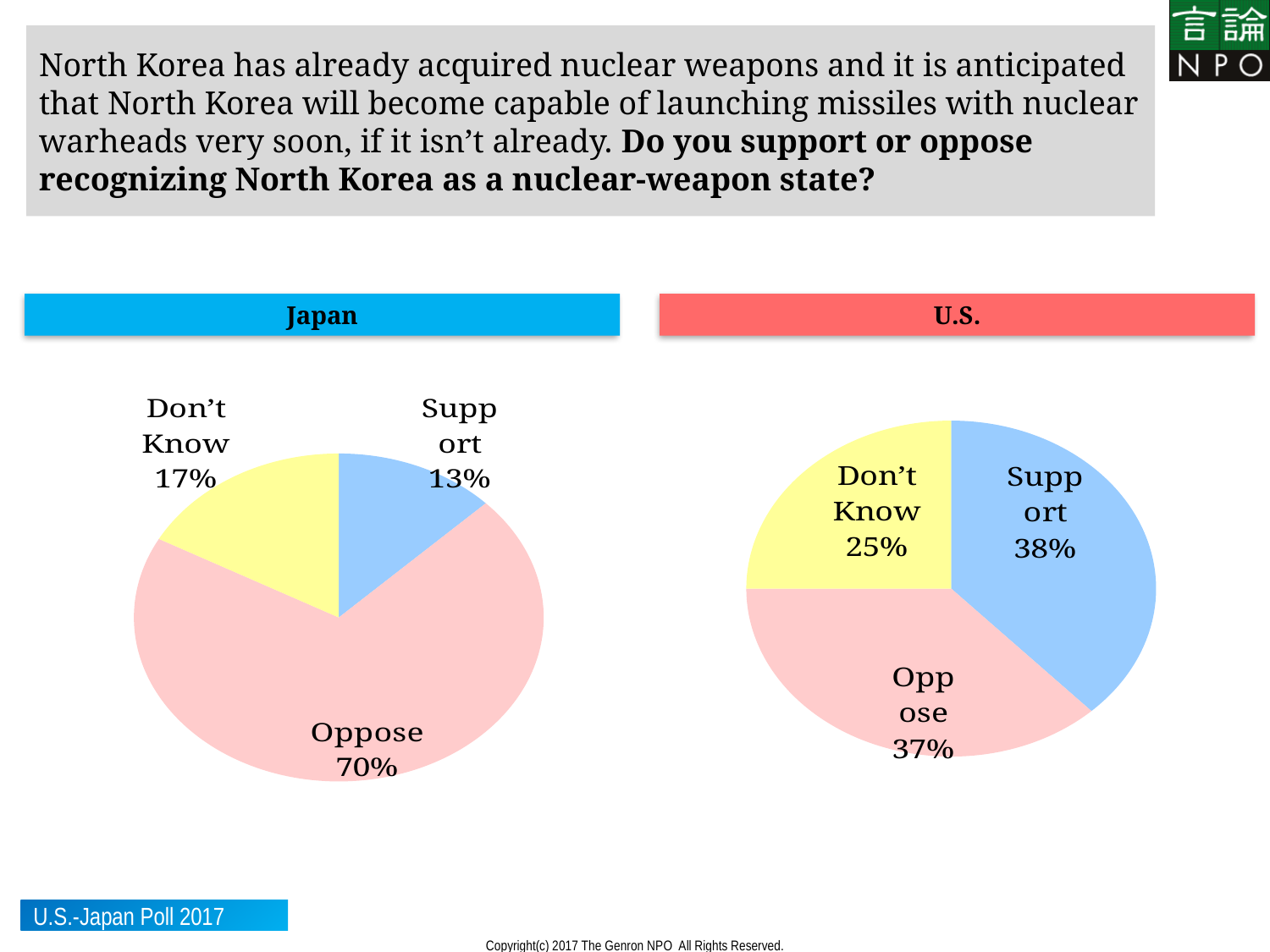
Which is larger: the Support share in the U.S. chart or the Support share in the Japan chart? U.S. What is the difference between the Oppose share in the Japan chart and the Oppose share in the U.S. chart? 33 percentage points In the Japan pie chart, which response has the largest share? Oppose In the Japan pie chart, which response has the smallest share? Support In the Japan pie chart, what share of respondents answered Support? 13% What type of chart is used to show the Japan results? Pie chart In the Japan pie chart, what percentage of respondents oppose recognizing North Korea as a nuclear-weapon state? 70% In the U.S. pie chart, what percentage of respondents answered Don't Know? 25% In the Japan pie chart, what is the difference between the Don't Know share and the Support share? 4 percentage points How many slices does the U.S. pie chart have? 3 In the U.S. pie chart, which response has the smallest share? Don't Know In the U.S. pie chart, what percentage of respondents answered Support? 38%